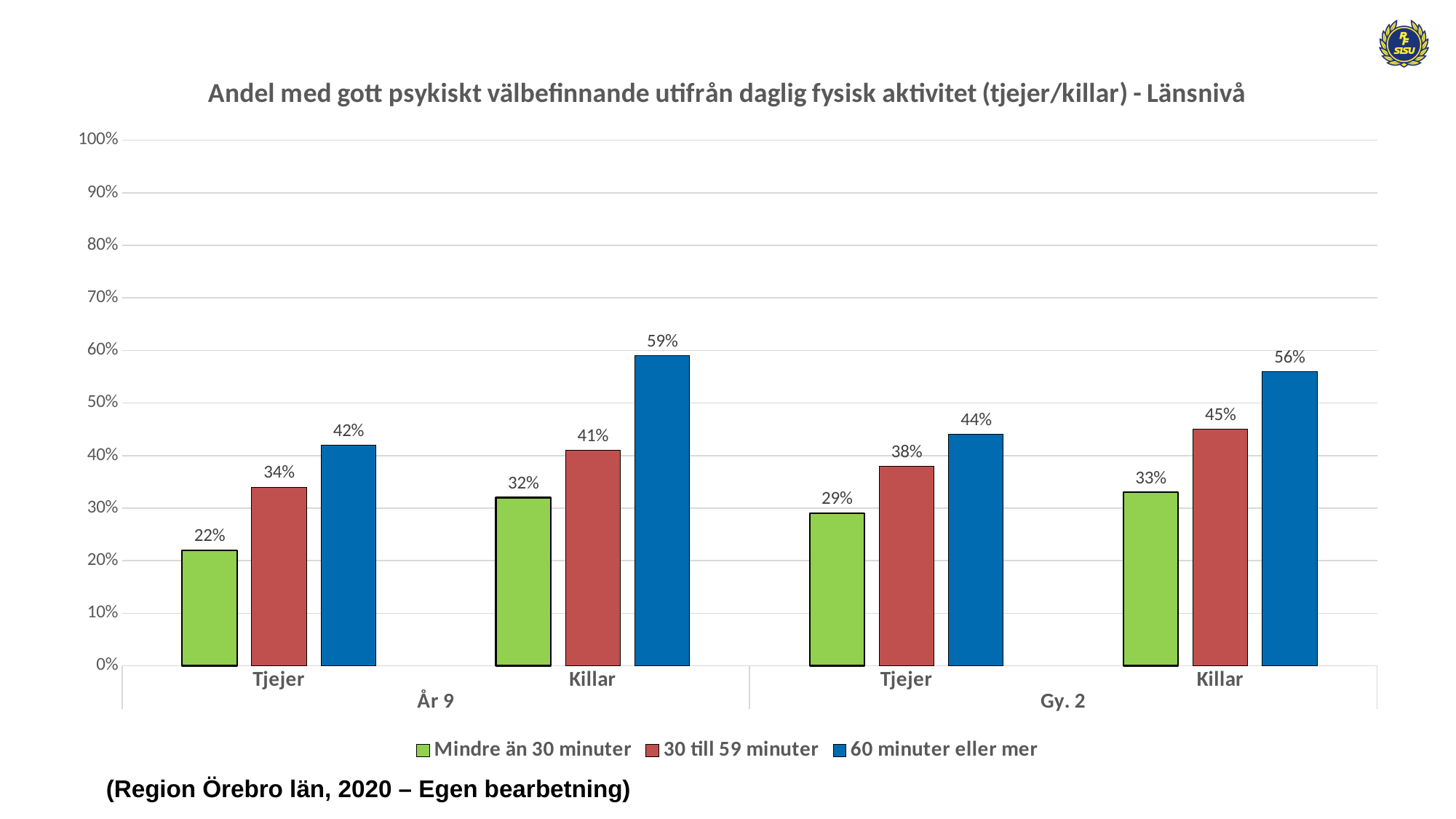
Which bar has the lowest value in the chart? Tjejer, År 9, Mindre än 30 minuter (22%) Within each group, do the values rise or fall as daily physical activity increases from 'Mindre än 30 minuter' to '60 minuter eller mer'? Rise How many series does the legend list? 3 What is the value for '60 minuter eller mer' among Killar in År 9? 59% What is the value for '30 till 59 minuter' among Killar in Gy. 2? 45% Which group and series has the highest value in the chart? Killar, År 9, 60 minuter eller mer (59%) What is the difference between '60 minuter eller mer' and 'Mindre än 30 minuter' for Tjejer in År 9? 20 percentage points Which colour represents '60 minuter eller mer' in the legend? Blue Which is larger: '30 till 59 minuter' for Killar in År 9 or '30 till 59 minuter' for Tjejer in Gy. 2? Killar in År 9 (41%) What kind of chart is shown on the slide? Bar chart Is the value for '60 minuter eller mer' among Killar in Gy. 2 greater or less than 50%? greater What is the value for 'Mindre än 30 minuter' among Tjejer in Gy. 2? 29%